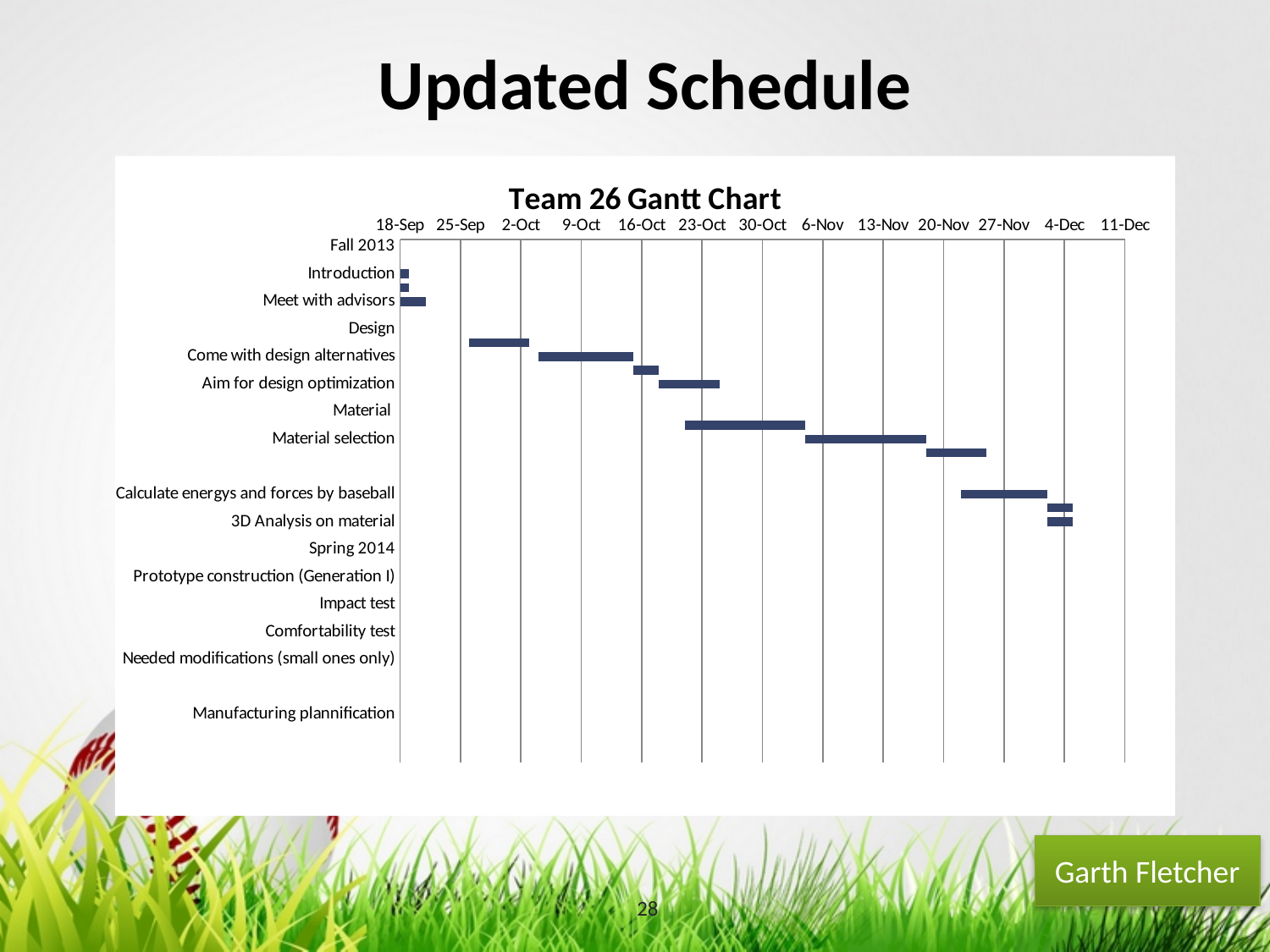
What is the title of the chart on the slide? Team 26 Gantt Chart What kind of chart is shown on the slide? Gantt chart (horizontal bar chart) How many date labels are shown along the chart's date axis? 13 Which task is listed last on the chart's vertical axis? Manufacturing plannification Do the task bars start progressively later in time as you move down the task list? Yes, later What is the latest date shown on the chart's date axis? 11-Dec Are any bars plotted for the tasks listed under Spring 2014? No What is the earliest date shown on the chart's date axis? 18-Sep Does the bar for Meet with advisors end before or after 25-Sep? before